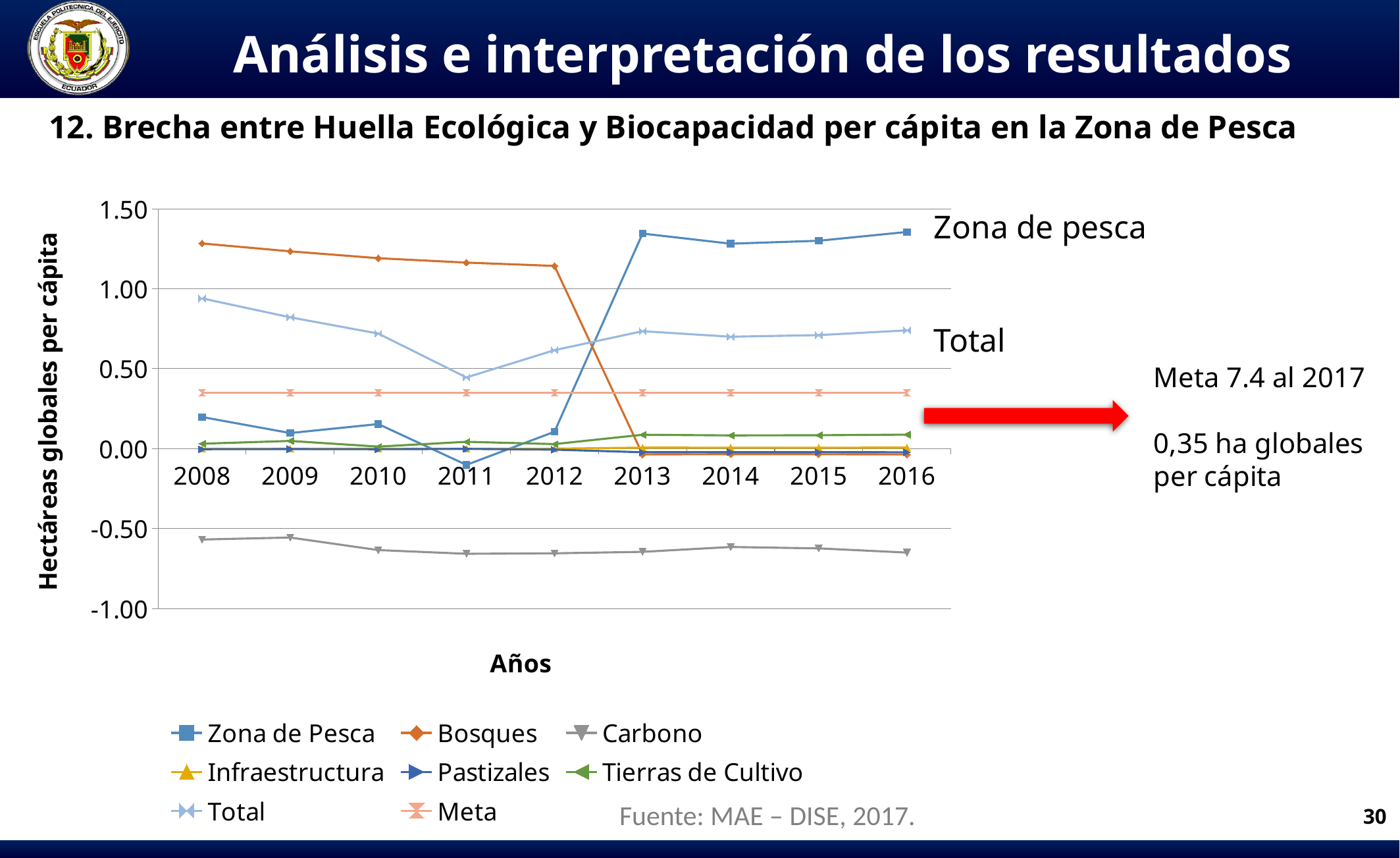
How many years are plotted along the x axis? 9 What kind of chart is shown on the slide? line chart Does the Bosques series rise or fall from 2008 to 2016? fall What is the title of the x axis? Años Which series has the highest value in 2008? Bosques Is the value for Bosques in 2008 greater or less than 1.00? greater Is the value for Carbono in 2011 greater or less than -0.50? less Which series has the lowest value in 2016? Carbono In 2016, which is larger: Zona de Pesca or Bosques? Zona de Pesca How many series does the legend list? 8 Is the value for Total in 2008 greater or less than 0.50? greater